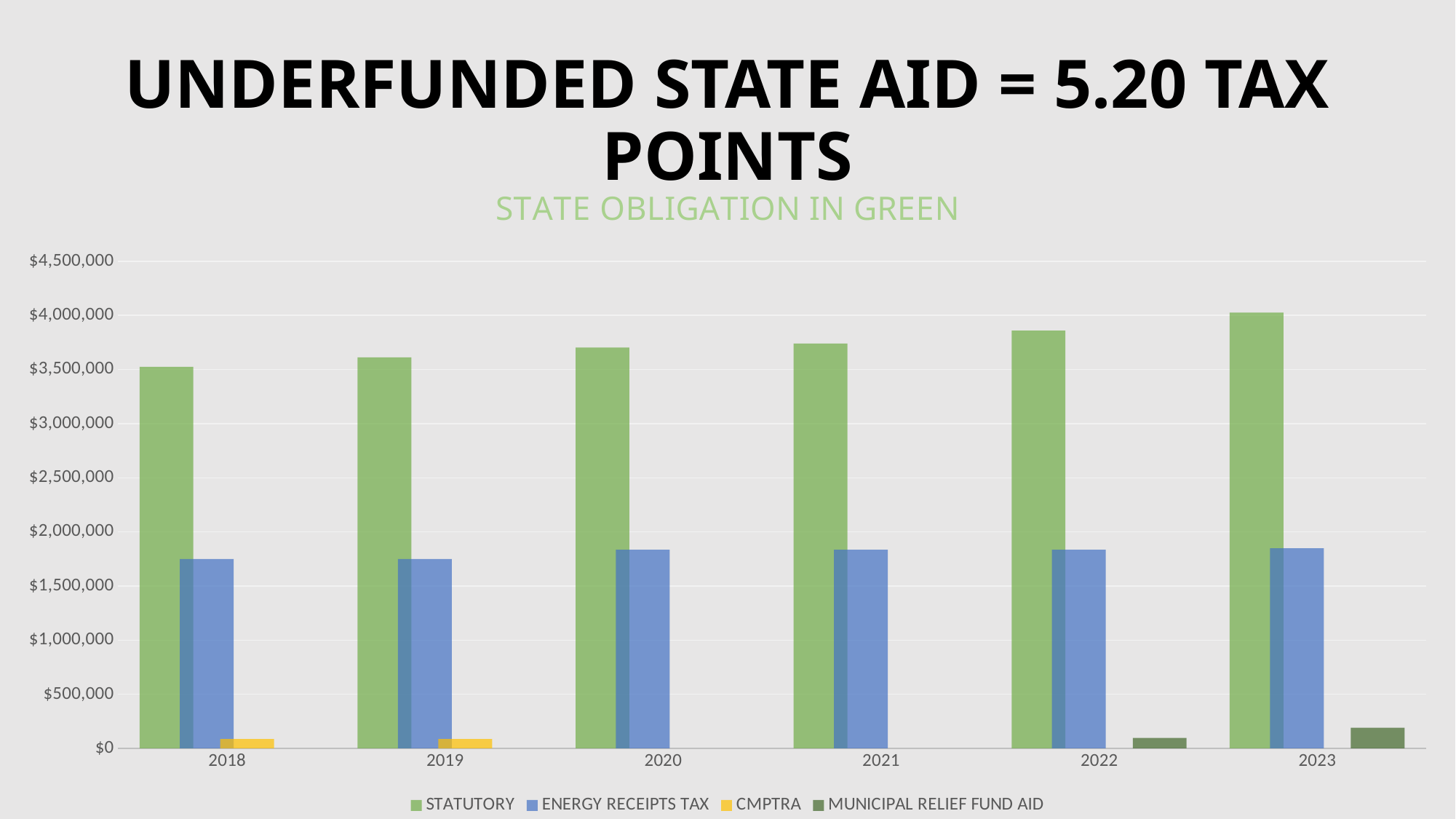
Do the STATUTORY values rise or fall from 2018 to 2023? rise In which year is the STATUTORY bar the lowest? 2018 In which year is the STATUTORY bar the highest? 2023 Is the ENERGY RECEIPTS TAX value for 2018 greater or less than $1,500,000? greater Is the STATUTORY value for 2018 greater or less than $4,000,000? less What kind of chart is shown on the slide? bar chart Is the MUNICIPAL RELIEF FUND AID value for 2023 greater or less than $500,000? less In 2021, which is larger: the STATUTORY value or the ENERGY RECEIPTS TAX value? STATUTORY How many series does the chart's legend list? 4 Which series is shown in yellow in the chart's legend? CMPTRA How many years are shown on the x axis of the chart? 6